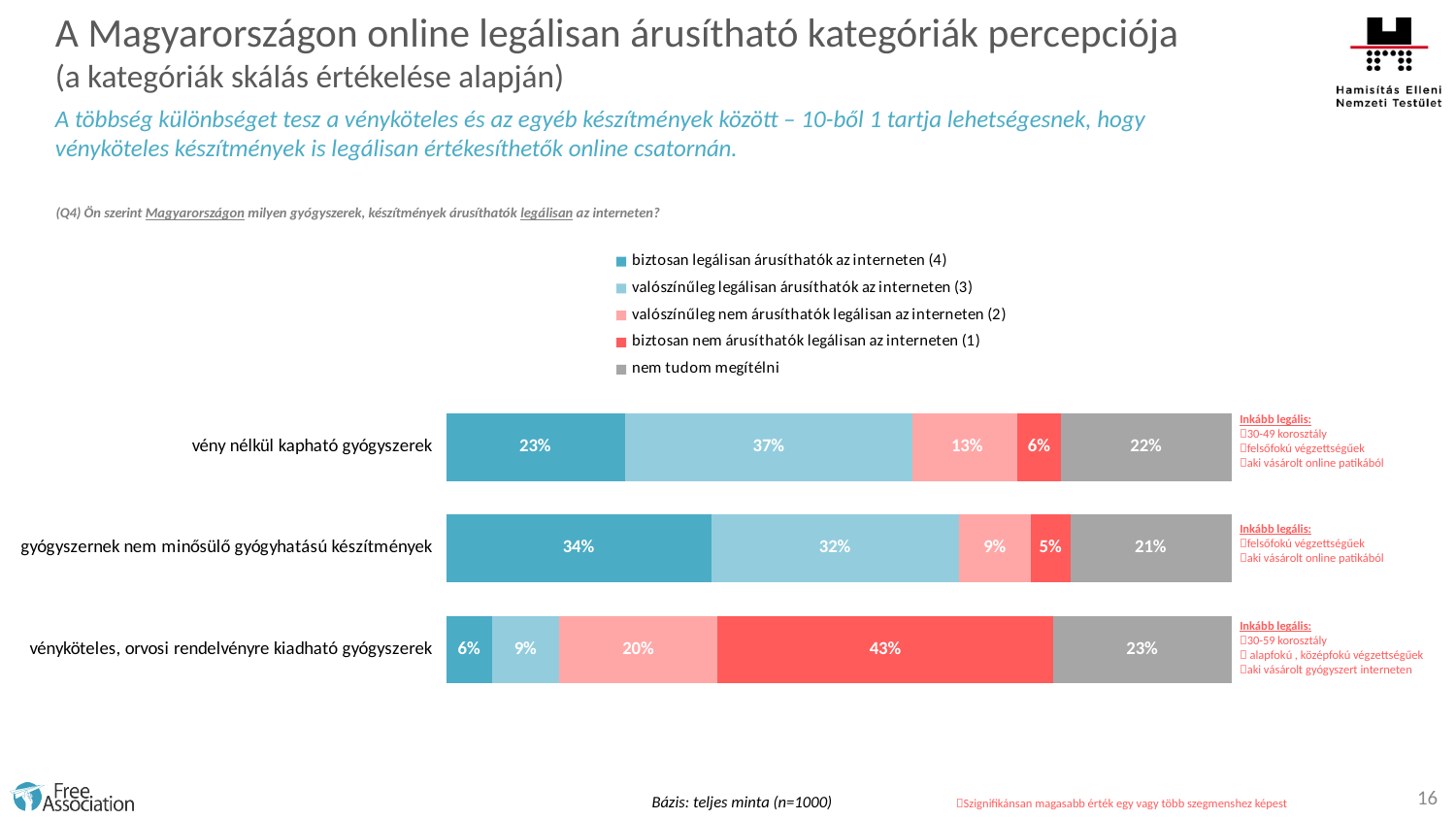
Which category has the highest value for 'biztosan legálisan árusíthatók az interneten (4)'? gyógyszernek nem minősülő gyógyhatású készítmények What is the value of 'valószínűleg legálisan árusíthatók az interneten (3)' for 'gyógyszernek nem minősülő gyógyhatású készítmények'? 32% What is the difference between the 'biztosan nem árusíthatók legálisan az interneten (1)' values for 'vényköteles, orvosi rendelvényre kiadható gyógyszerek' and 'vény nélkül kapható gyógyszerek'? 37% What is the value of 'nem tudom megítélni' for 'gyógyszernek nem minősülő gyógyhatású készítmények'? 21% What kind of chart is shown on the slide? stacked bar chart Which category has the lowest value for 'biztosan nem árusíthatók legálisan az interneten (1)'? gyógyszernek nem minősülő gyógyhatású készítmények How many series does the legend list? 5 What is the combined value of 'biztosan legálisan árusíthatók az interneten (4)' and 'valószínűleg legálisan árusíthatók az interneten (3)' for 'vény nélkül kapható gyógyszerek'? 60% What is the value of 'biztosan legálisan árusíthatók az interneten (4)' for 'vény nélkül kapható gyógyszerek'? 23% How many categories are plotted on the chart? 3 Which is larger: the 'valószínűleg nem árusíthatók legálisan az interneten (2)' value for 'vény nélkül kapható gyógyszerek' or for 'vényköteles, orvosi rendelvényre kiadható gyógyszerek'? vényköteles, orvosi rendelvényre kiadható gyógyszerek What is the value of 'biztosan nem árusíthatók legálisan az interneten (1)' for 'vényköteles, orvosi rendelvényre kiadható gyógyszerek'? 43%